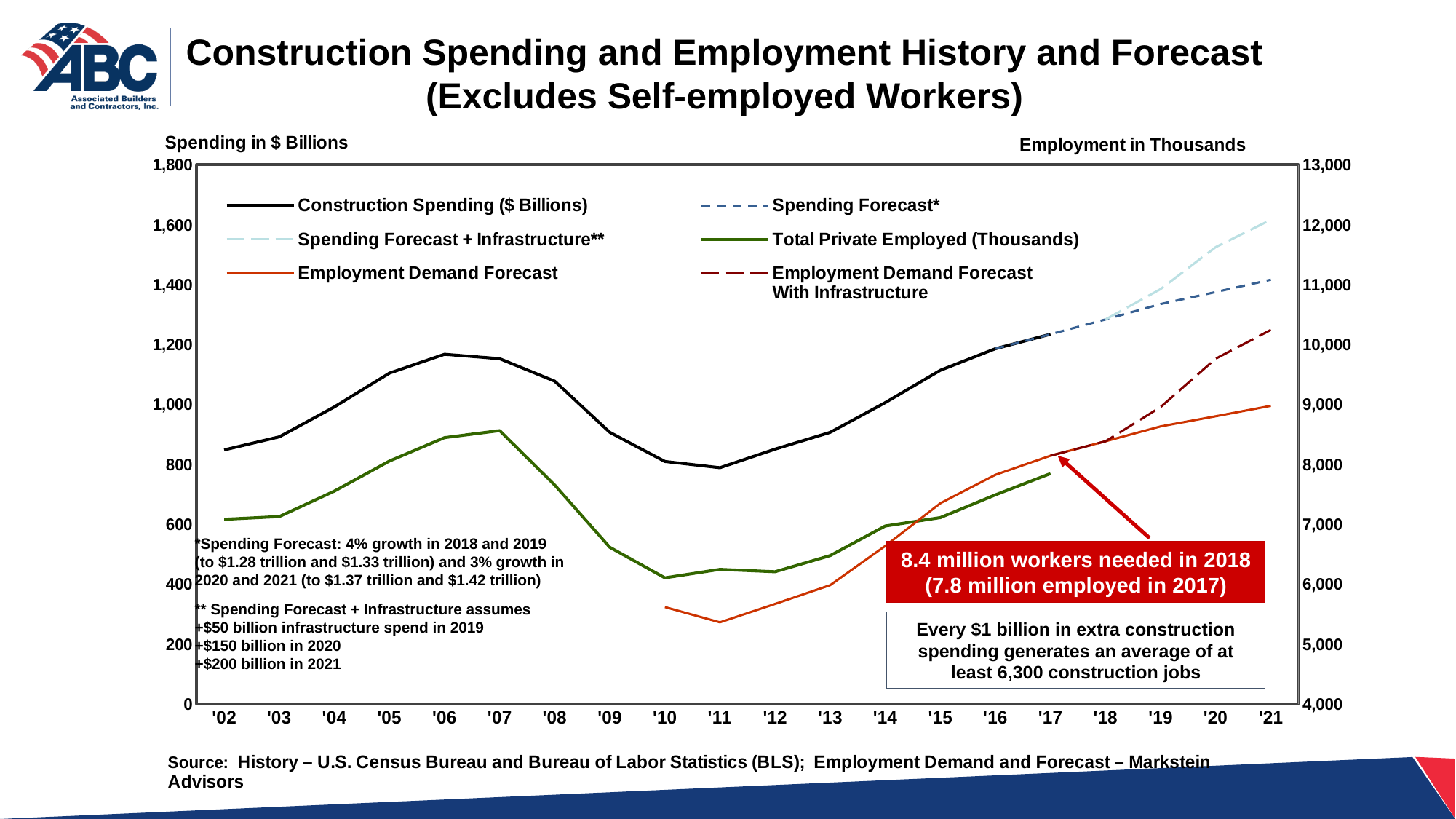
How many years are labelled along the x axis of the chart? 20 Is the Construction Spending value for '06 greater or less than 1,000? greater Is the Total Private Employed value for '10 greater or less than 7,000? less Is the Employment Demand Forecast With Infrastructure value for '21 greater or less than 10,000? greater What is the label of the right-hand vertical axis? Employment in Thousands In which year does Total Private Employed reach its highest value? '07 What kind of chart is shown on the slide? line chart Does Construction Spending rise or fall from '07 to '10? fall In '21, which is larger: Spending Forecast + Infrastructure or Spending Forecast? Spending Forecast + Infrastructure How many series does the chart's legend list? 6